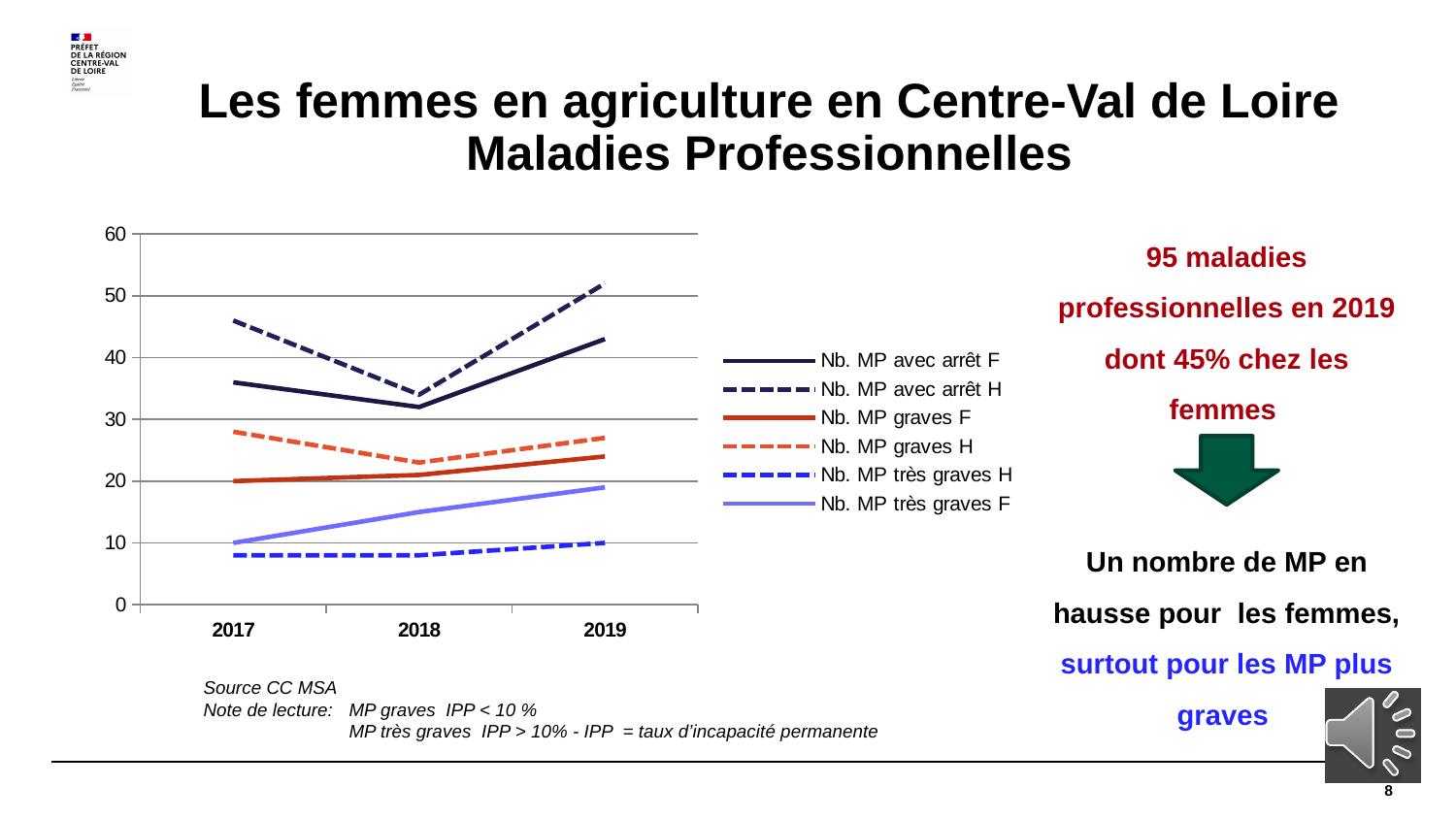
Is the value for Nb. MP avec arrêt F in 2018 greater or less than 40? less In 2019, which is larger: Nb. MP très graves F or Nb. MP très graves H? Nb. MP très graves F Does the value for Nb. MP très graves F rise or fall from 2017 to 2019? rise How many series does the chart's legend list? 6 Is the value for Nb. MP avec arrêt H in 2019 greater or less than 40? greater What kind of chart is shown on the slide? line chart Which series has the highest value in 2019? Nb. MP avec arrêt H Which series has the lowest value in 2017? Nb. MP très graves H In 2017, which is larger: Nb. MP avec arrêt H or Nb. MP avec arrêt F? Nb. MP avec arrêt H Is the value for Nb. MP graves H in 2018 greater or less than 30? less Does the value for Nb. MP avec arrêt H rise or fall from 2017 to 2018? fall How many years are shown on the x axis of the chart? 3